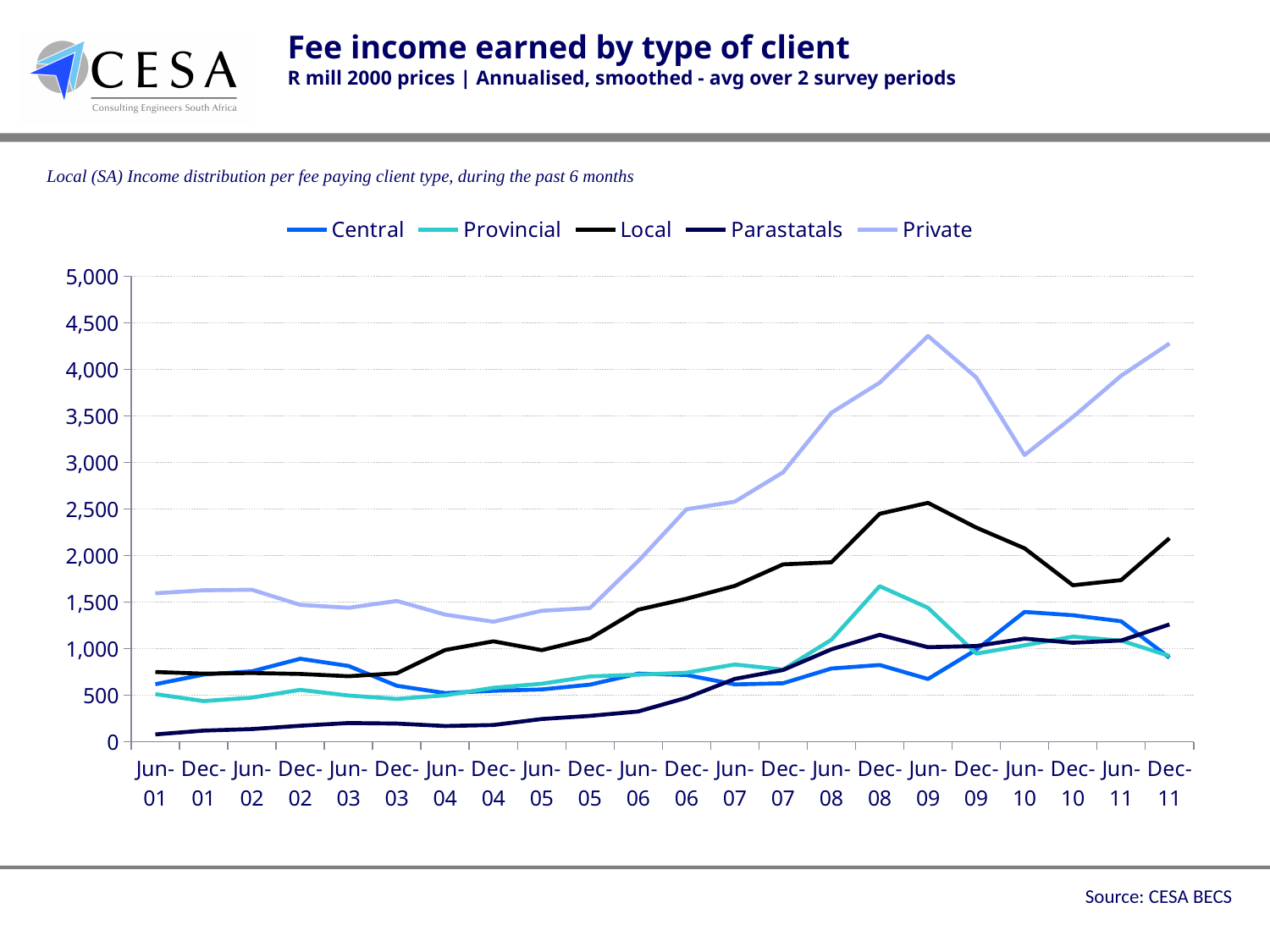
Does the Private series rise or fall between Jun-09 and Jun-10? fall What kind of chart is shown on the slide? line chart At Dec-08, which is larger: Provincial or Central? Provincial Is the value for Local at Jun-09 greater or less than 2,000? greater Is the value for Private at Jun-09 greater or less than 4,000? greater Which client type has the lowest fee income at Jun-01? Parastatals Is the value for Parastatals at Jun-01 greater or less than 500? less How many survey periods are shown along the x axis? 22 How many series does the legend list? 5 What is the title of the chart? Fee income earned by type of client Which client type has the highest fee income at Dec-11? Private